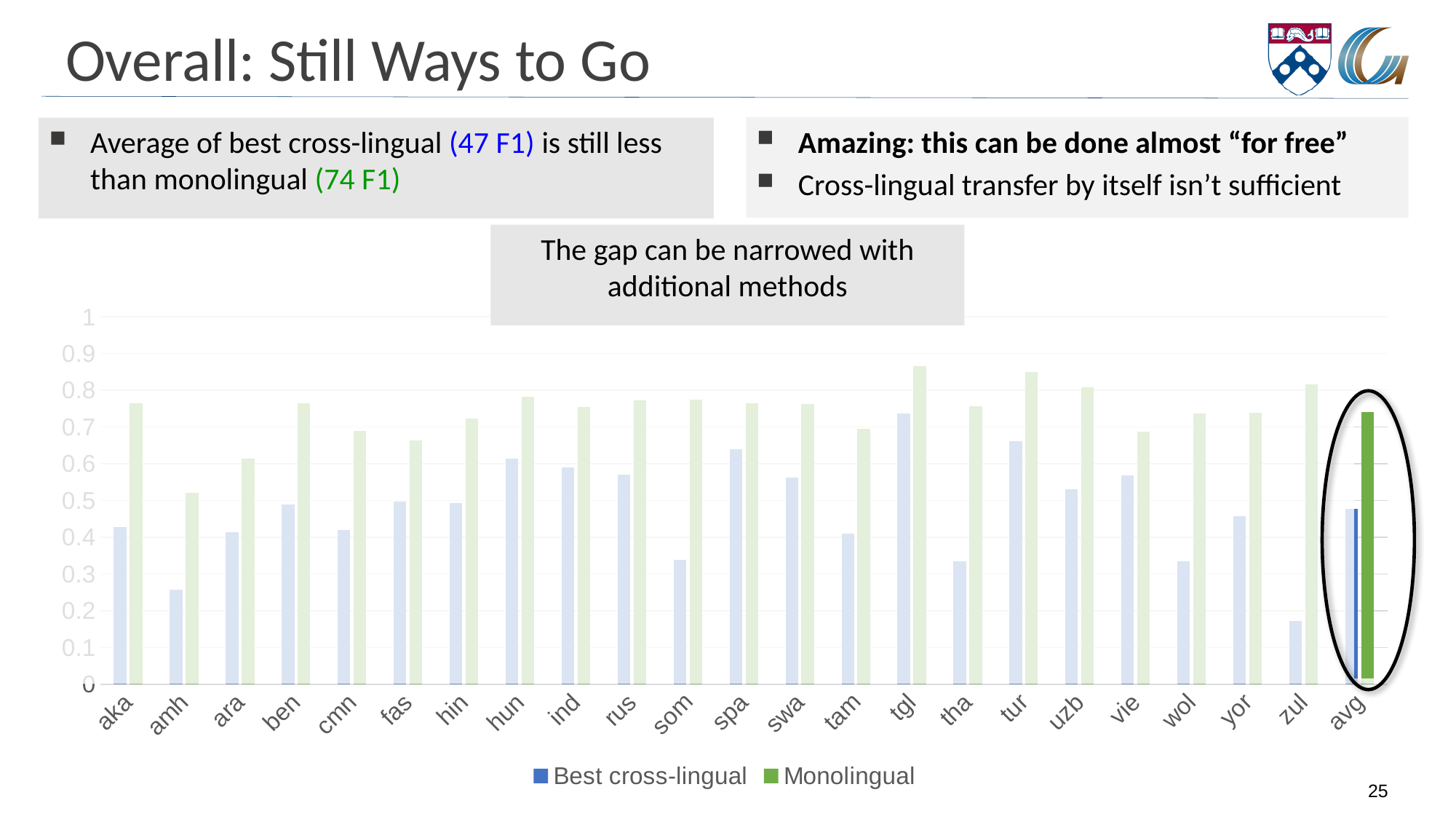
Is the Monolingual value for amh greater or less than 0.6? less Which series is shown in green in the legend? Monolingual Is the Monolingual value for tgl greater or less than 0.8? greater What kind of chart is shown on the slide? bar chart Is the Best cross-lingual value for tgl greater or less than 0.7? greater For aka, which is larger: the Best cross-lingual value or the Monolingual value? Monolingual How many categories are shown on the x axis of the chart? 23 Which category has the lowest Monolingual value? amh How many series does the legend list? 2 Which category has the highest Best cross-lingual value? tgl Which category has the lowest Best cross-lingual value? zul